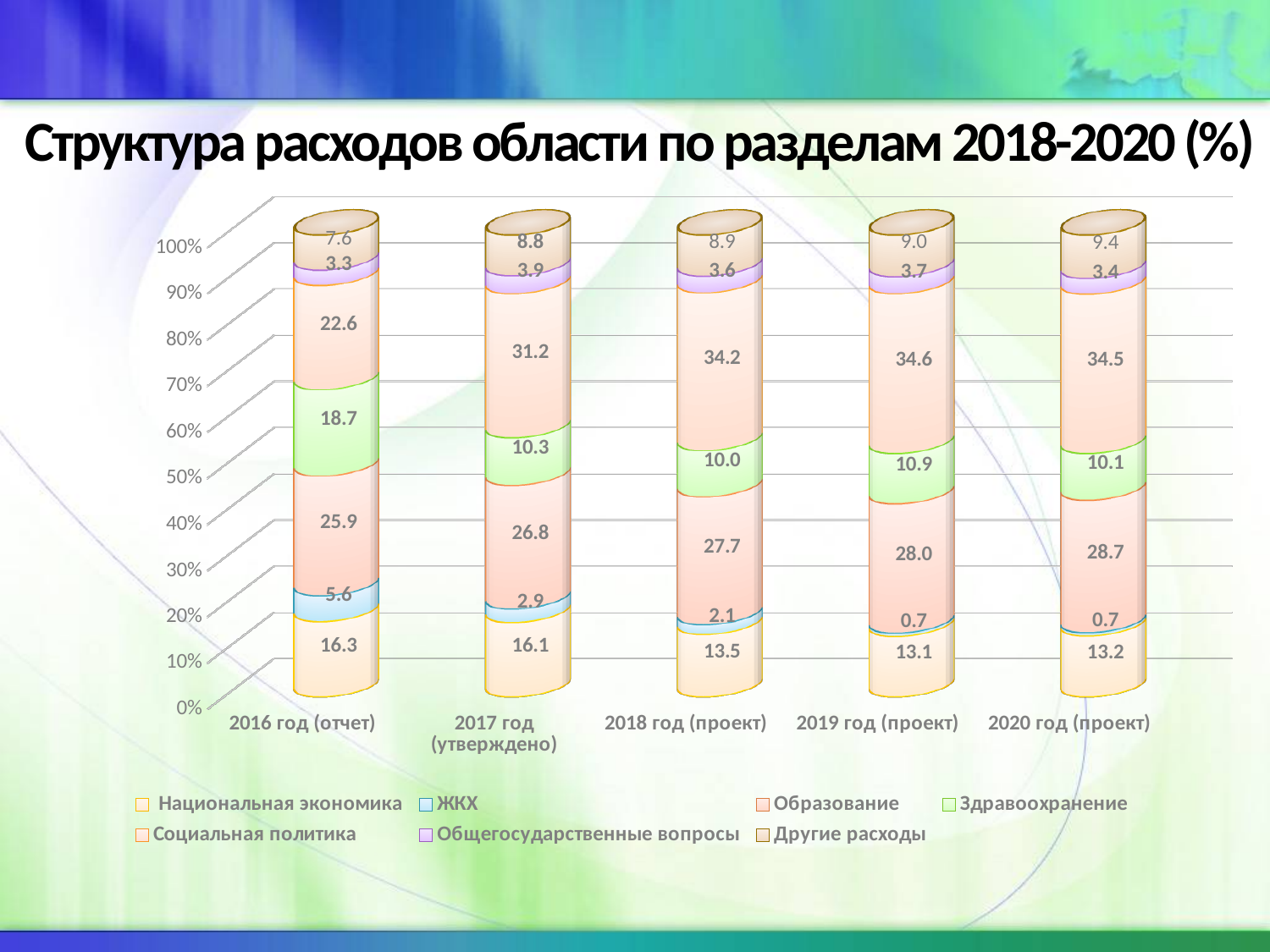
Which is larger: Образование in 2016 год (отчет) or Здравоохранение in 2016 год (отчет)? Образование In which year is the value for Национальная экономика lowest? 2019 год (проект) How many series does the legend list? 7 Does the value for ЖКХ rise or fall from 2016 год (отчет) to 2019 год (проект)? Fall What is the difference between the Социальная политика values for 2017 год (утверждено) and 2016 год (отчет)? 8.6 What is the value for Социальная политика in 2016 год (отчет)? 22.6 What is the value for Образование in 2018 год (проект)? 27.7 What type of chart is shown on the slide? Stacked bar chart What is the value for Другие расходы in 2020 год (проект)? 9.4 How many categories (years) are shown on the x axis? 5 What is the value for ЖКХ in 2017 год (утверждено)? 2.9 In which year is the value for Здравоохранение highest? 2016 год (отчет)